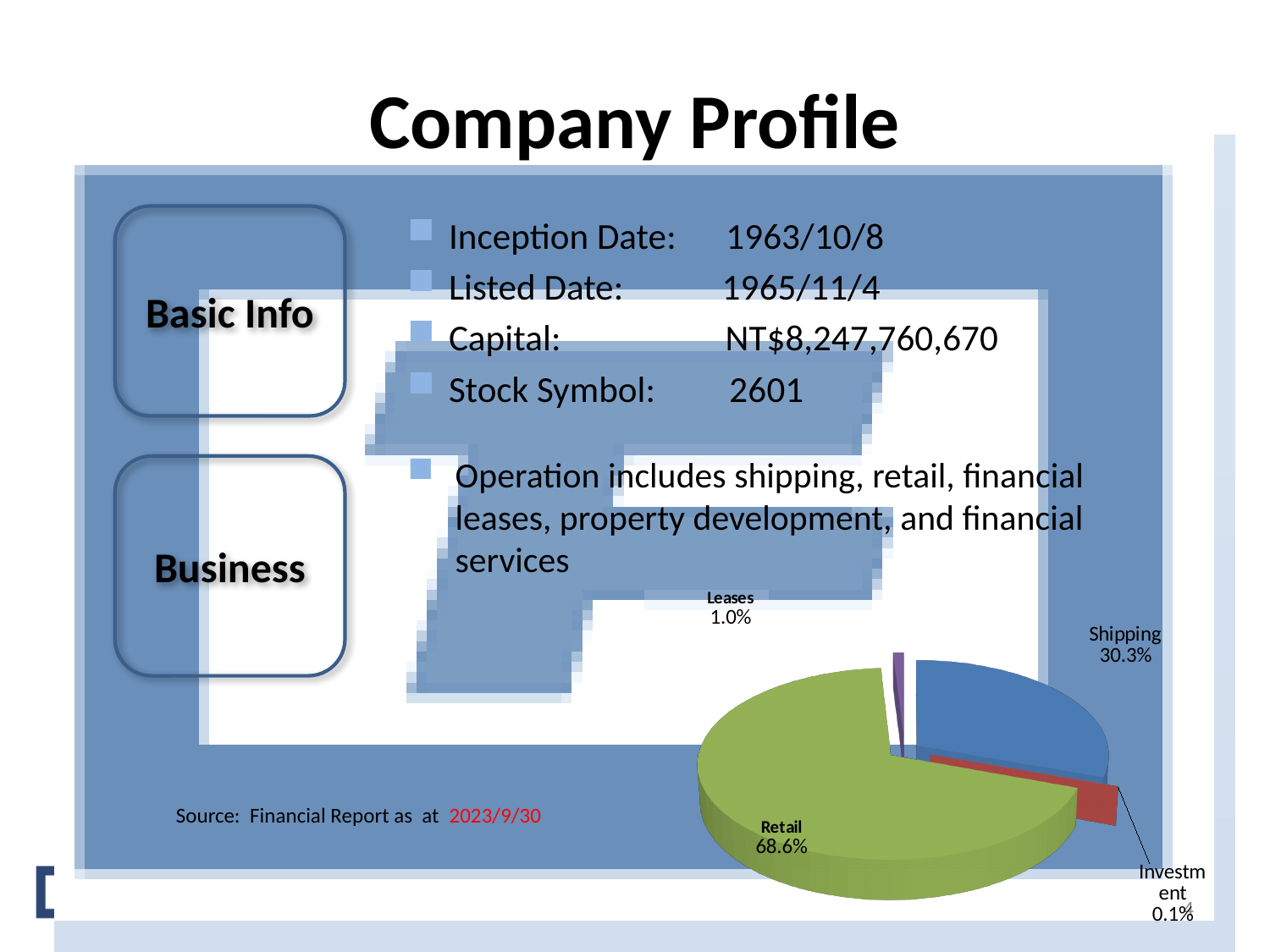
What is the difference in percentage points between the Retail and Shipping slices? 38.3 What share of the pie does Shipping account for? 30.3% What colour is the Retail slice of the pie chart? green What is the difference in percentage points between the Leases and Investment slices? 0.9 Which is larger, the Shipping slice or the Leases slice? Shipping Which slice of the pie is the largest? Retail What share of the pie does Investment account for? 0.1% What share of the pie does Retail account for? 68.6% How many slices does the pie chart have? 4 Which slice of the pie is the smallest? Investment What kind of chart is shown on the slide? pie chart What share of the pie does Leases account for? 1.0%